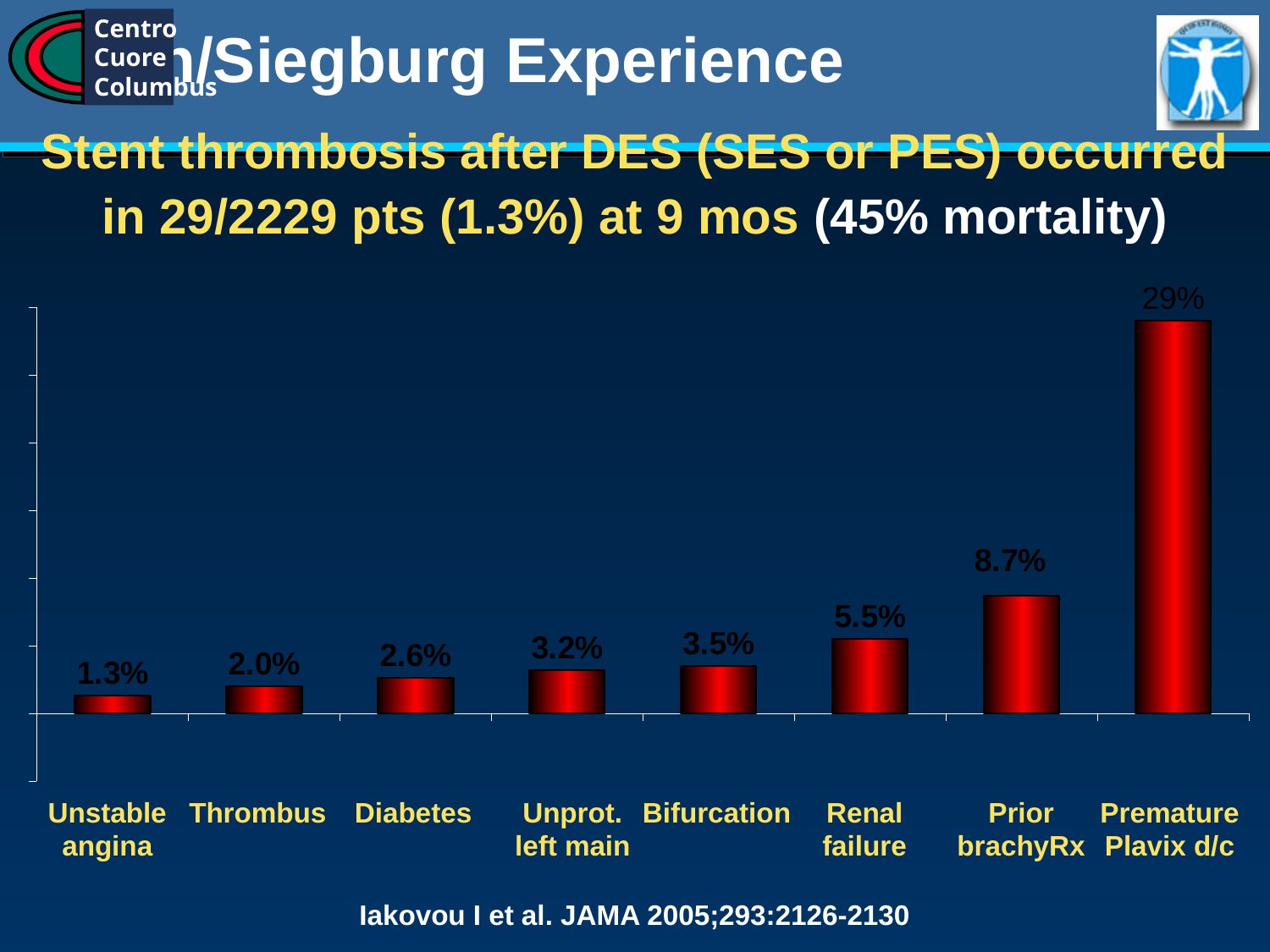
What is the value for Premature Plavix d/c? 29% Which is larger, the value for Thrombus or the value for Unprot. left main? Unprot. left main What is the value for Prior brachyRx? 8.7% Which category has the highest value? Premature Plavix d/c How many categories are shown on the x axis? 8 Which category has the lowest value? Unstable angina What is the value for Renal failure? 5.5% What is the difference between the values for Bifurcation and Diabetes? 0.9% What is the difference between the values for Prior brachyRx and Renal failure? 3.2% Do the values rise or fall from left to right along the x axis? Rise What kind of chart is shown on the slide? Bar chart What is the value for Unstable angina? 1.3%